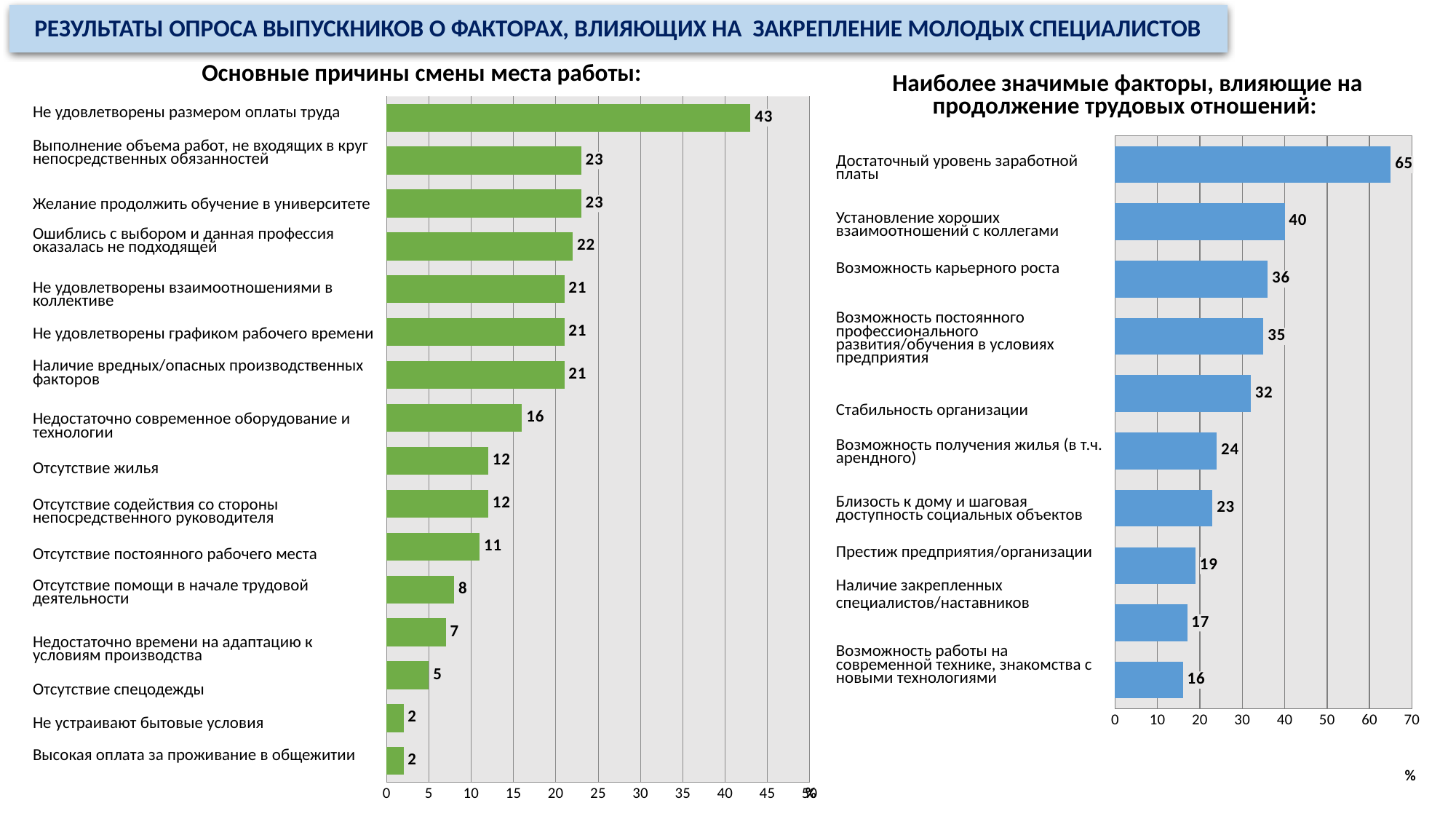
In the right chart 'Наиболее значимые факторы, влияющие на продолжение трудовых отношений', how many categories are plotted? 10 What type of chart is the right chart 'Наиболее значимые факторы, влияющие на продолжение трудовых отношений'? Bar chart In the left chart 'Основные причины смены места работы', what is the difference between 'Не удовлетворены размером оплаты труда' and 'Желание продолжить обучение в университете'? 20 In the left chart 'Основные причины смены места работы', how many categories are plotted? 16 In the left chart 'Основные причины смены места работы', which is larger: 'Отсутствие жилья' or 'Отсутствие помощи в начале трудовой деятельности'? Отсутствие жилья In the left chart 'Основные причины смены места работы', what is the value for 'Не удовлетворены размером оплаты труда'? 43 In the left chart 'Основные причины смены места работы', what is the value for 'Недостаточно современное оборудование и технологии'? 16 In the right chart 'Наиболее значимые факторы, влияющие на продолжение трудовых отношений', which category has the lowest value? Возможность работы на современной технике, знакомства с новыми технологиями In the left chart 'Основные причины смены места работы', which category has the highest value? Не удовлетворены размером оплаты труда In the right chart 'Наиболее значимые факторы, влияющие на продолжение трудовых отношений', what is the value for 'Достаточный уровень заработной платы'? 65 In the right chart 'Наиболее значимые факторы, влияющие на продолжение трудовых отношений', what is the difference between 'Достаточный уровень заработной платы' and 'Установление хороших взаимоотношений с коллегами'? 25 In the right chart 'Наиболее значимые факторы, влияющие на продолжение трудовых отношений', what is the value for 'Возможность карьерного роста'? 36